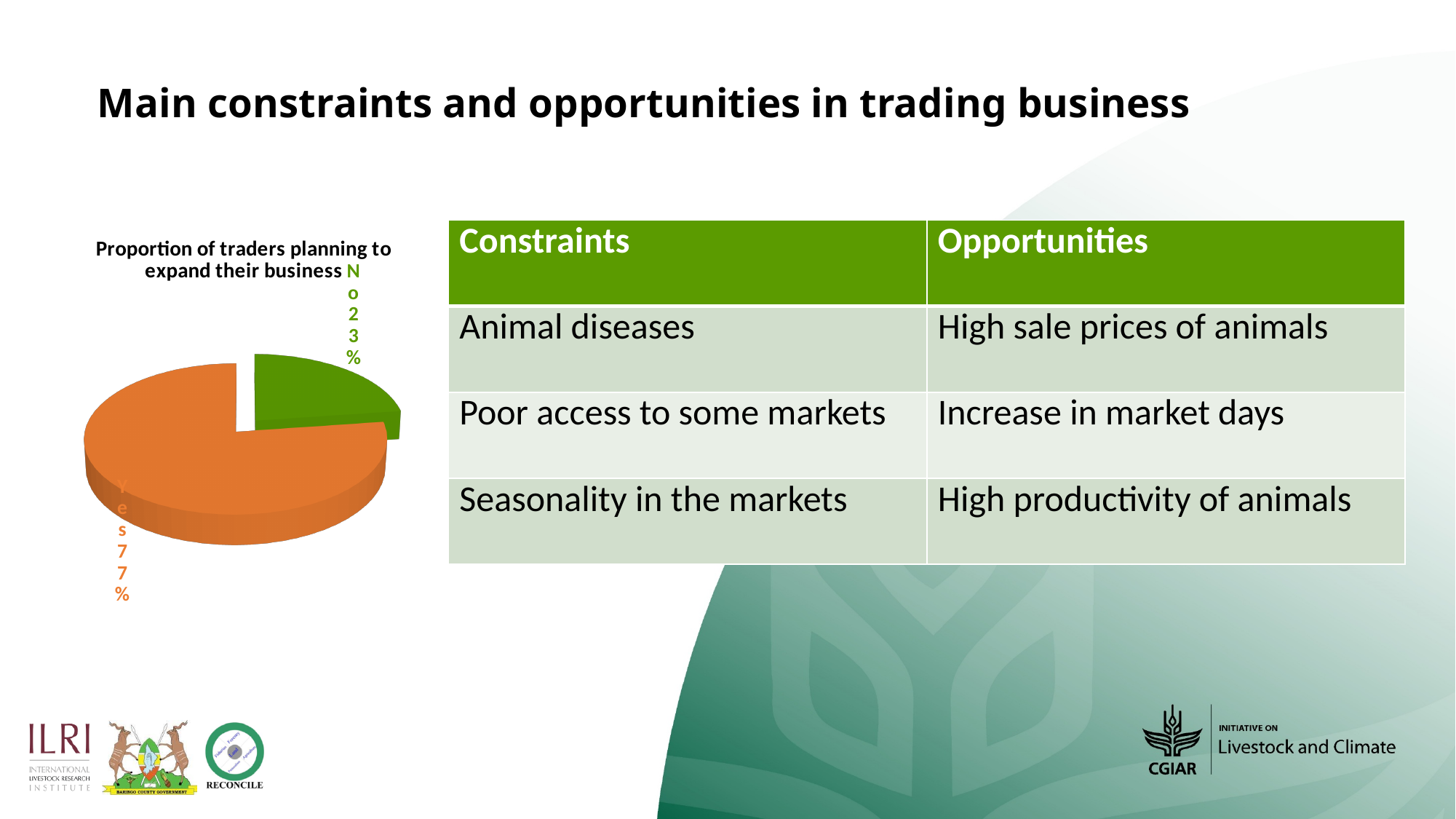
What kind of chart is shown on the slide? pie chart What percentage of traders answered Yes to planning to expand their business? 77% Which is larger, the Yes slice or the No slice? Yes What is the difference in percentage points between the Yes and No slices? 54 Which slice of the pie chart is the smallest? No Which slice of the pie chart is the largest? Yes How many slices does the pie chart have? 2 What colour is the Yes slice of the pie chart? orange What percentage of traders answered No to planning to expand their business? 23% What is the title of the chart on the slide? Proportion of traders planning to expand their business What share of the pie does the No slice represent? 23%